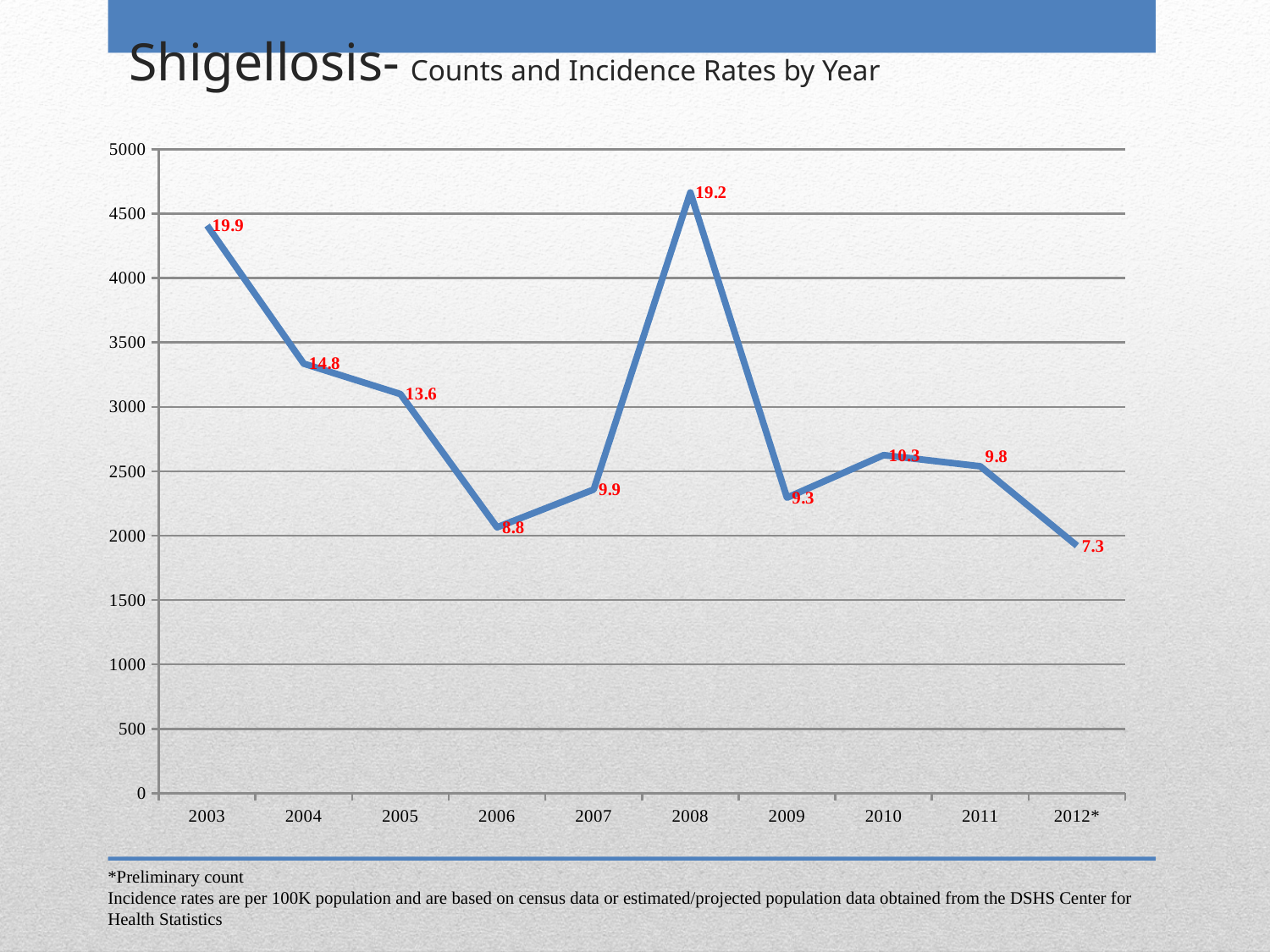
Is the count for 2006 greater or less than 2500? less What incidence rate is labelled for 2012*? 7.3 What incidence rate is labelled for 2008? 19.2 Which year has the higher count, 2003 or 2004? 2003 What incidence rate is labelled for 2010? 10.3 What is the difference between the labelled incidence rates for 2008 and 2009? 9.9 Is the count for 2003 greater or less than 4000? greater Do the counts rise or fall from 2003 to 2006? fall How many years are plotted along the x axis? 10 Which year has the lowest labelled incidence rate? 2012* What kind of chart is shown on the slide? line chart Which year has the highest count on the line? 2008